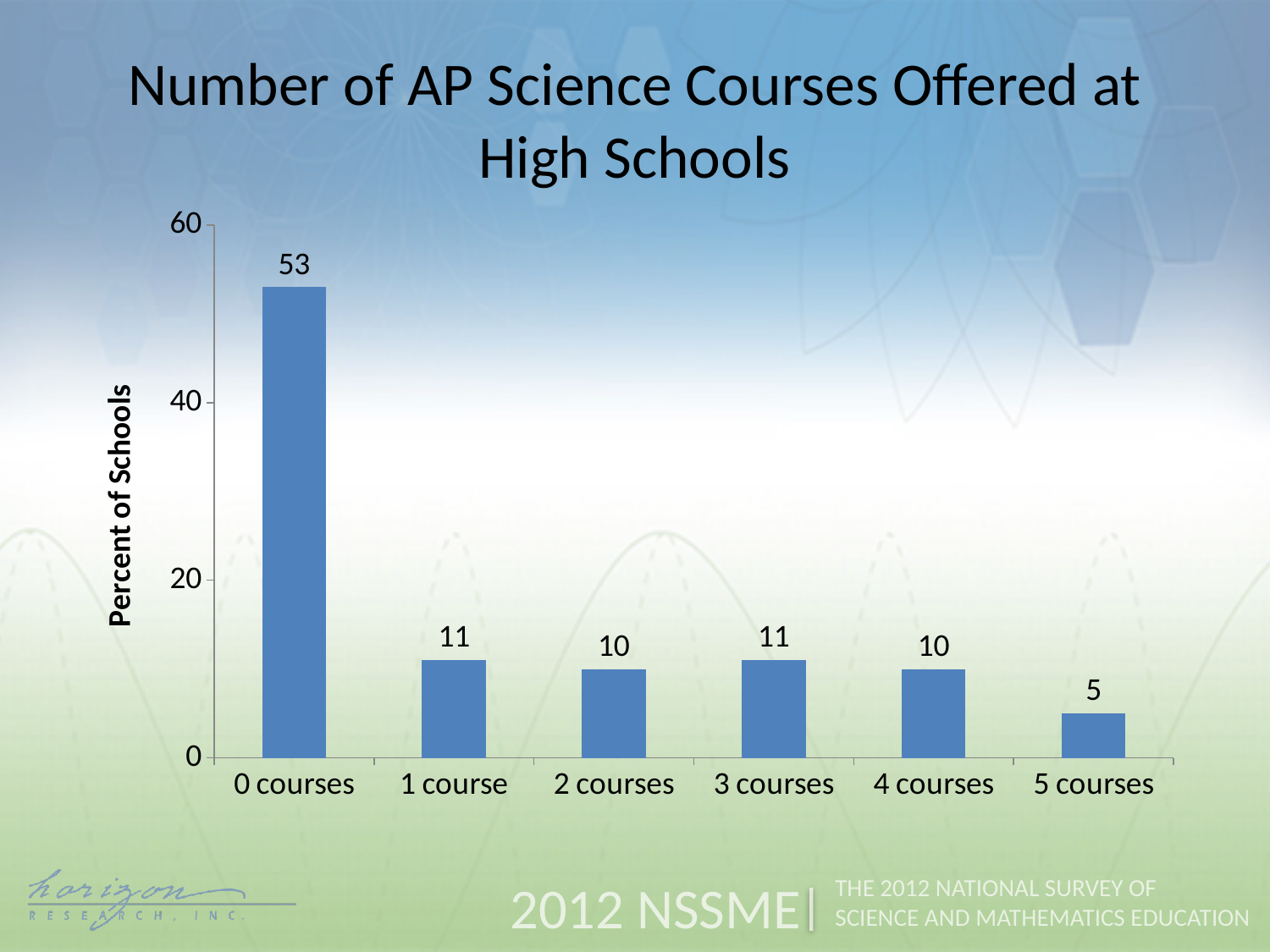
Which category has the lowest percent of schools? 5 courses Is the value for 0 courses greater or less than 40? greater Which category has the highest percent of schools? 0 courses What is the difference between the values for 0 courses and 1 course? 42 What is the label of the y axis? Percent of Schools What is the difference between the values for 4 courses and 5 courses? 5 What is the value for 3 courses? 11 Which is larger, the value for 1 course or the value for 5 courses? 1 course What kind of chart is shown on the slide? bar chart How many categories are shown on the x axis? 6 What percent of schools offer 0 AP science courses? 53 What is the value for 5 courses? 5